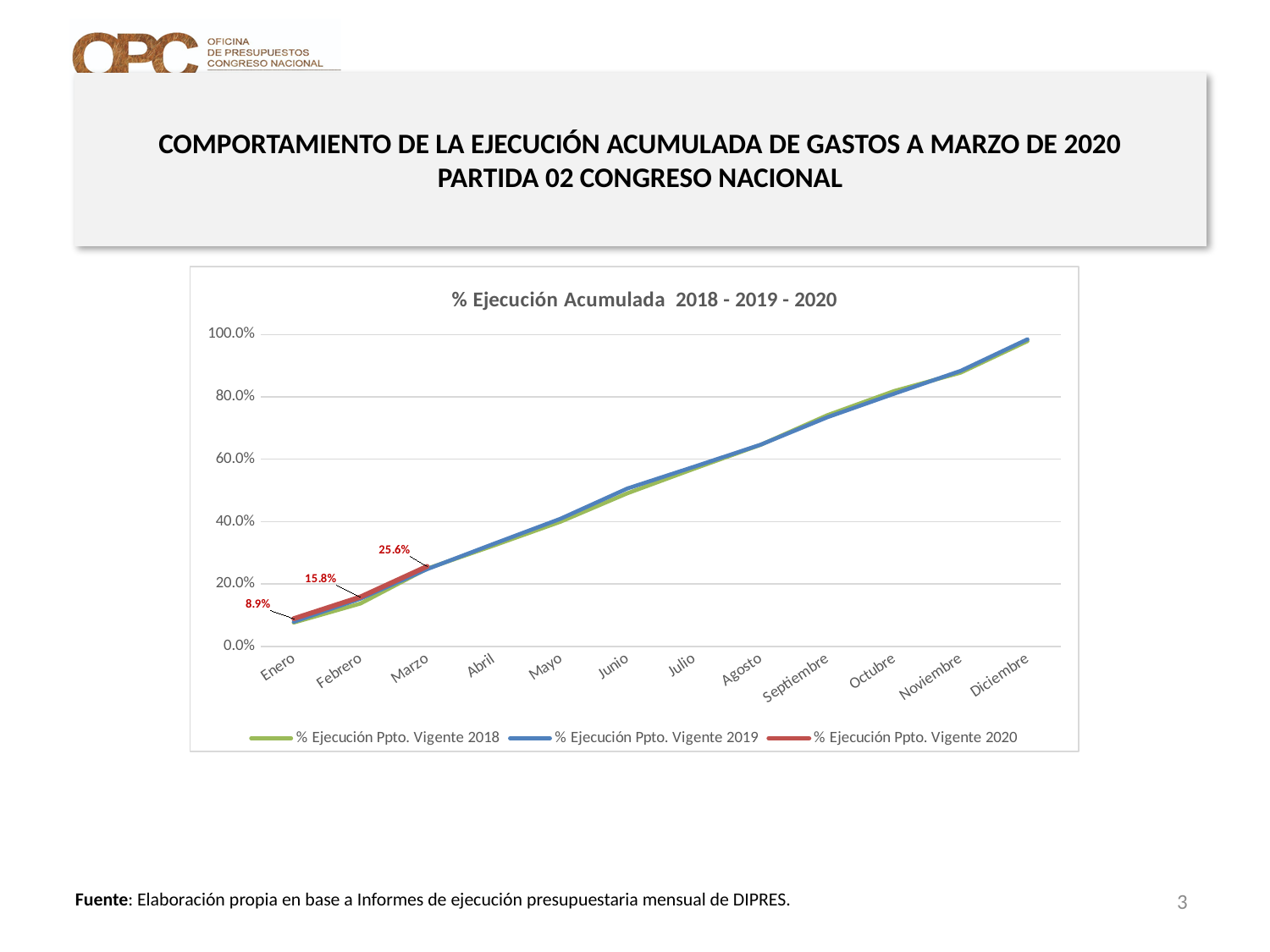
How many months are shown on the x axis? 12 How many series does the legend list? 3 Which month has the highest value in the % Ejecución Ppto. Vigente 2020 series? Marzo What is the difference between the Febrero and Enero values in the % Ejecución Ppto. Vigente 2020 series? 6.9% What is the title of the chart? % Ejecución Acumulada 2018 - 2019 - 2020 Do the values for the % Ejecución Ppto. Vigente 2019 series rise or fall from Enero to Diciembre? Rise What is the value for Febrero in the % Ejecución Ppto. Vigente 2020 series? 15.8% What is the value for Enero in the % Ejecución Ppto. Vigente 2020 series? 8.9% What kind of chart is shown on the slide? Line chart Is the value for Junio in the % Ejecución Ppto. Vigente 2019 series greater or less than 60.0%? less What is the value for Marzo in the % Ejecución Ppto. Vigente 2020 series? 25.6% What is the difference between the Marzo and Febrero values in the % Ejecución Ppto. Vigente 2020 series? 9.8%